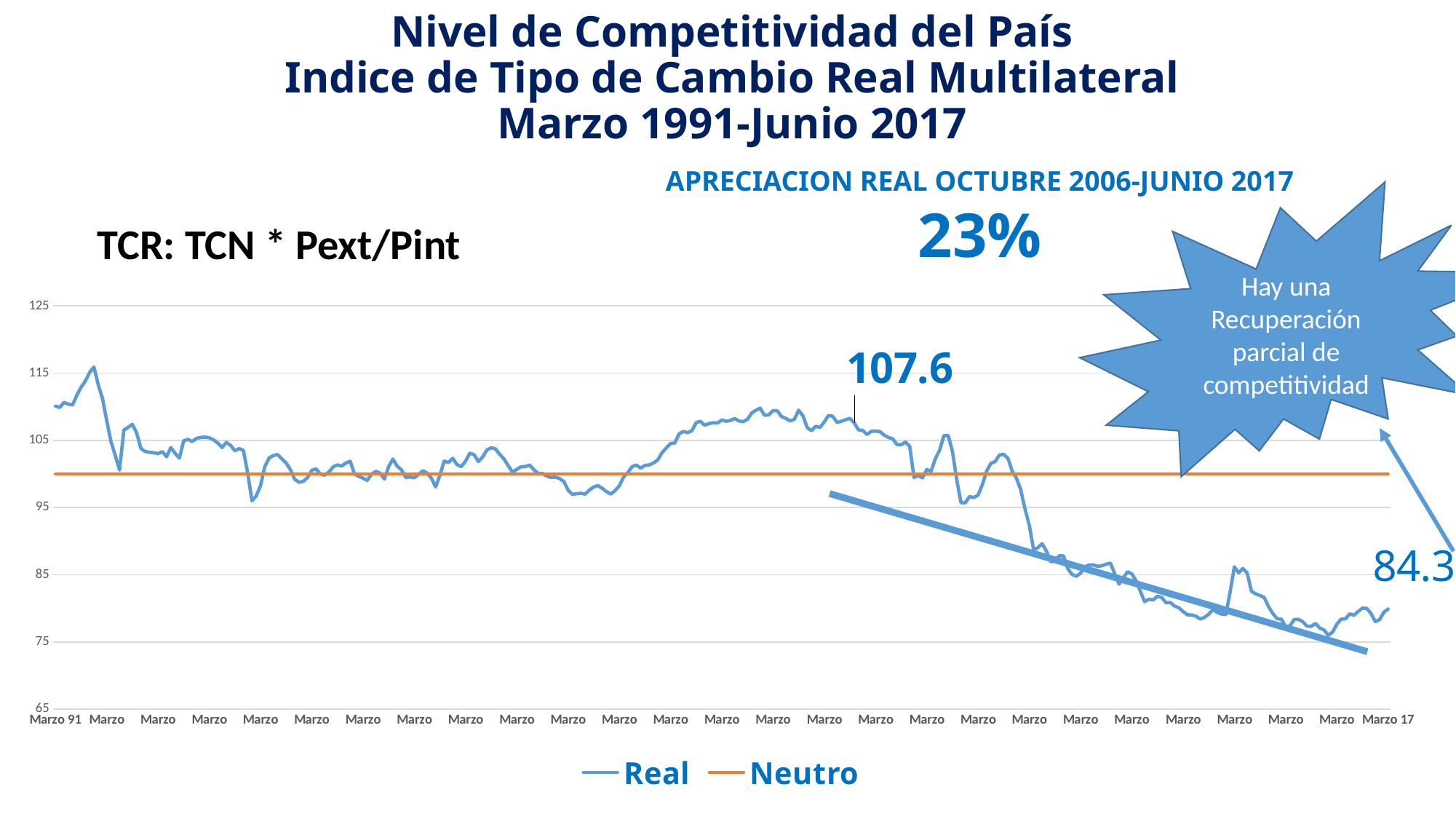
Is the Real value at Marzo 17 greater or less than 85? less What is the difference between the labelled peak value 107.6 and the labelled end value 84.3? 23.3 Is the Real value at Marzo 91 greater or less than 105? greater What real appreciation percentage is stated on the slide for October 2006-June 2017? 23% Does the Real series rise or fall from its 2006 peak to 2016? fall What kind of chart is shown on the slide? line chart Which is larger, the Real value at Marzo 91 or the Real value at Marzo 17? Marzo 91 What value is labelled at the peak of the Real series around 2006? 107.6 What are the two series named in the legend? Real and Neutro How many series does the legend list? 2 What value is labelled at the end of the Real series (June 2017)? 84.3